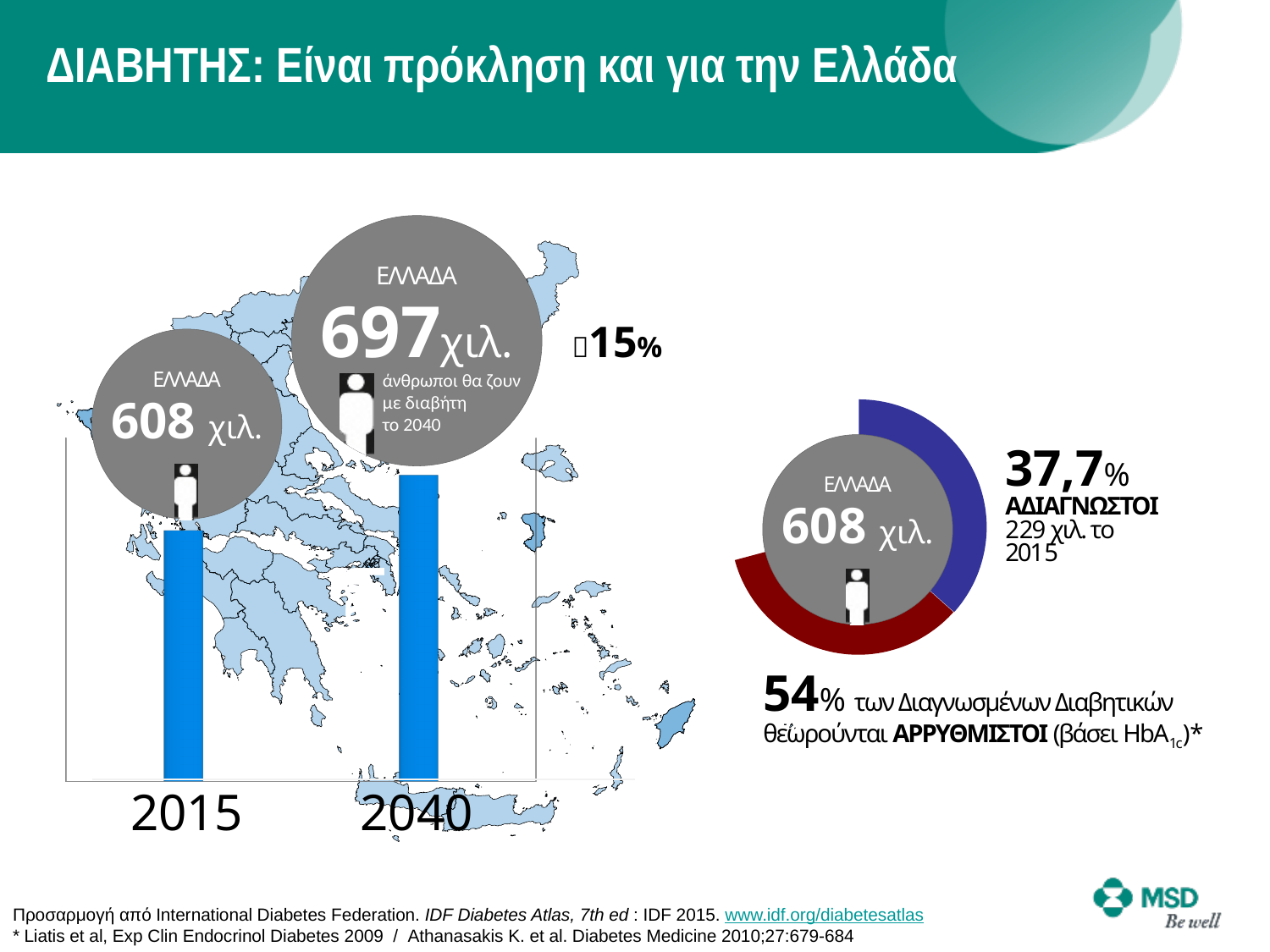
On the bar chart over the map of Greece, which year has the shorter bar? 2015 On the bar chart over the map of Greece, what value is shown for 2015? 608 χιλ. On the bar chart over the map of Greece, which year has the taller bar? 2040 What kind of chart is shown over the map of Greece? bar chart On the donut chart on the right, what share is labelled as ΑΔΙΑΓΝΩΣΤΟΙ (undiagnosed)? 37,7% How many bars does the bar chart over the map of Greece have? 2 On the donut chart on the right, how many people (in thousands) are labelled as undiagnosed in 2015? 229 χιλ. On the bar chart over the map of Greece, what percentage increase is labelled next to the 2040 bubble? 15% On the bar chart over the map of Greece, what value is shown for 2040? 697 χιλ. On the bar chart over the map of Greece, by how much does the 2040 value exceed the 2015 value? 89 χιλ. On the bar chart over the map of Greece, is the value for 2040 larger or smaller than the value for 2015? larger On the bar chart over the map of Greece, do the values rise or fall from 2015 to 2040? rise